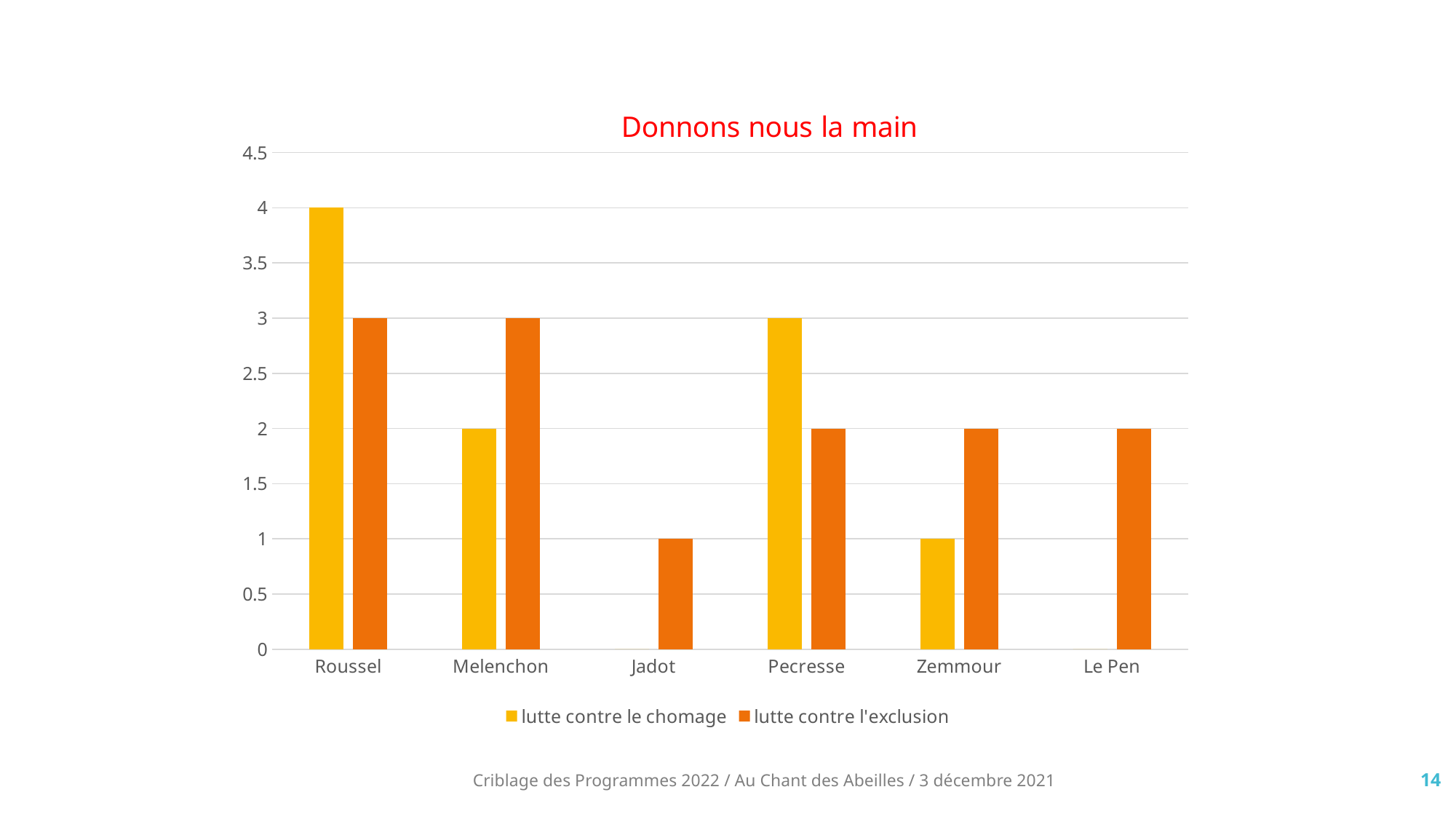
Which candidate has the lowest value in the 'lutte contre l'exclusion' series? Jadot What is the value for Melenchon in the 'lutte contre l'exclusion' series? 3 What is the value for Le Pen in the 'lutte contre l'exclusion' series? 2 What kind of chart is shown on the slide? bar chart How many candidates are shown on the x axis? 6 What is the title of the chart? Donnons nous la main How many series does the legend list? 2 What is the value for Jadot in the 'lutte contre l'exclusion' series? 1 What is the difference between Roussel's 'lutte contre le chomage' value and Zemmour's 'lutte contre le chomage' value? 3 For Pecresse, which series has the larger value: 'lutte contre le chomage' or 'lutte contre l'exclusion'? lutte contre le chomage Which candidate has the highest value in the 'lutte contre le chomage' series? Roussel What is the value for Roussel in the 'lutte contre le chomage' series? 4